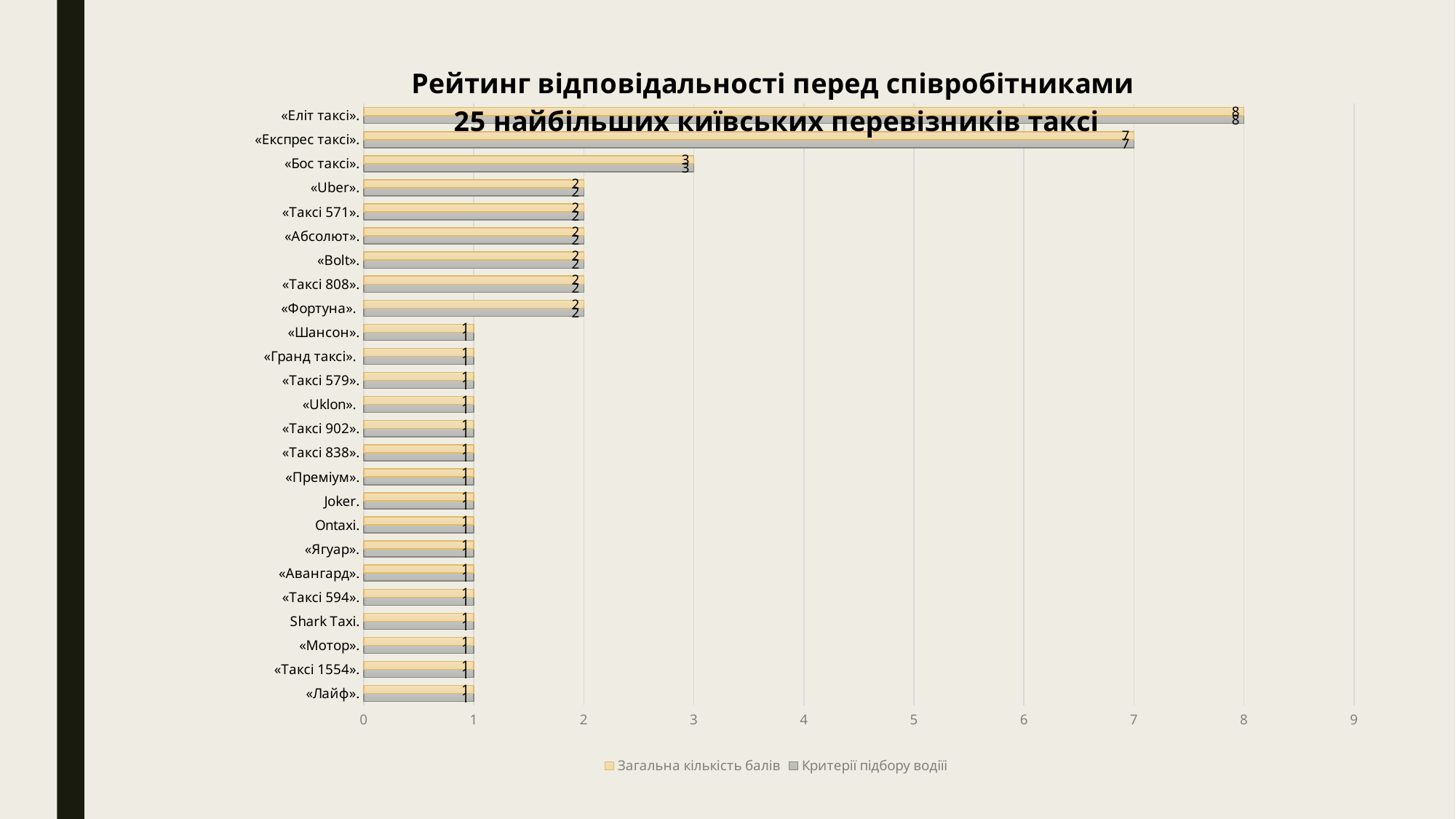
Which company has the highest value of «Загальна кількість балів»? «Еліт таксі» How many taxi companies (categories) are plotted on the chart? 25 What is the value of «Критерії підбору водіїв» for «Експрес таксі»? 7 What is the value of «Загальна кількість балів» for «Бос таксі»? 3 What is the value of «Критерії підбору водіїв» for «Uklon»? 1 What is the difference between the «Загальна кількість балів» values for «Еліт таксі» and «Експрес таксі»? 1 How many series does the legend list? 2 What is the value of «Загальна кількість балів» for «Еліт таксі»? 8 What is the title of the chart? Рейтинг відповідальності перед співробітниками 25 найбільших київських перевізників таксі Which has a larger «Загальна кількість балів» value, «Бос таксі» or «Bolt»? «Бос таксі» What type of chart is shown on the slide? bar chart What is the value of «Загальна кількість балів» for «Uber»? 2